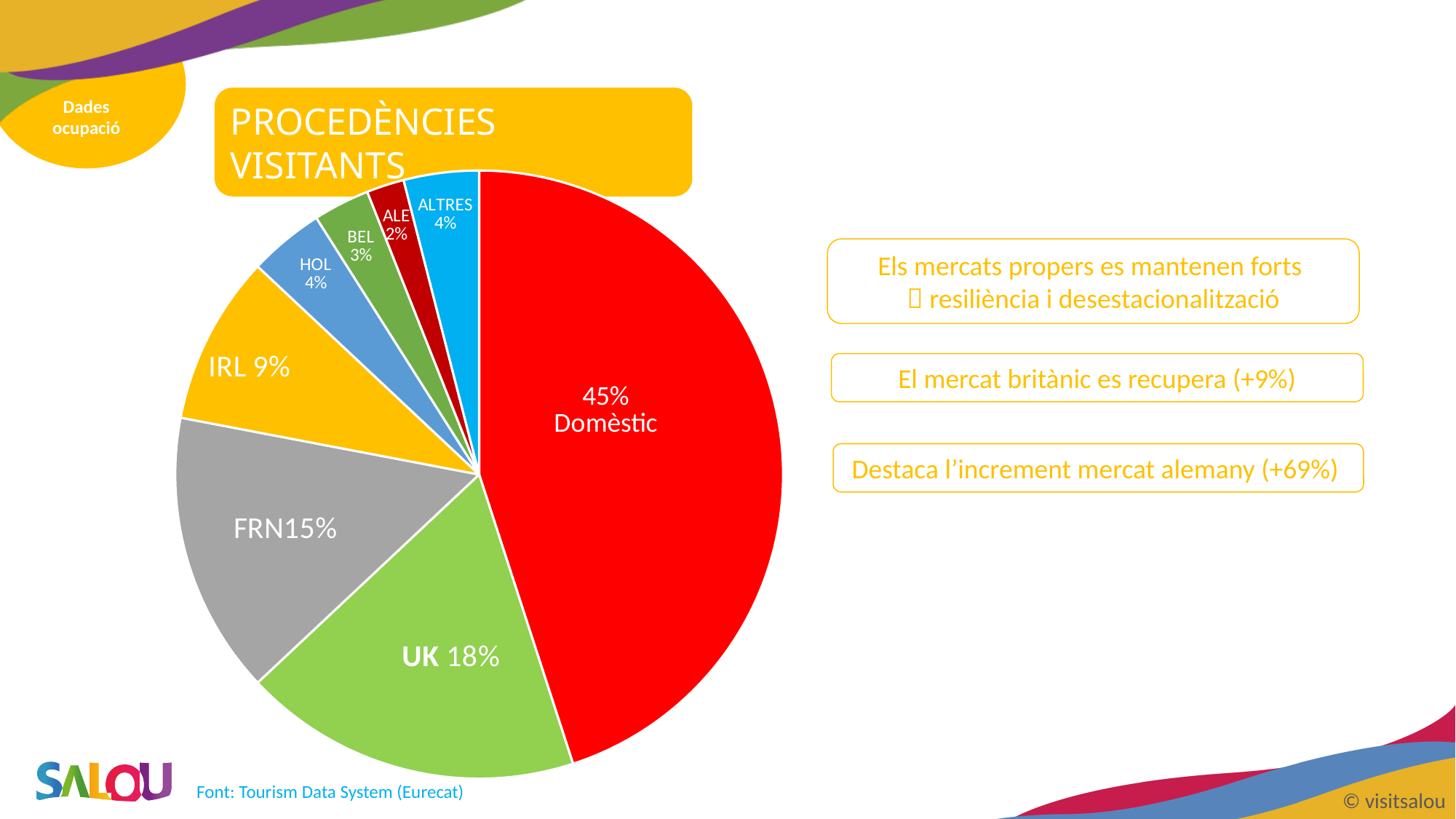
What percentage is shown for FRN? 15% Which is larger, the IRL slice or the HOL slice? IRL What kind of chart is shown on the slide? Pie chart What is the title of the chart? PROCEDÈNCIES VISITANTS How many slices does the pie chart have? 8 What percentage is shown for IRL? 9% What is the difference in percentage points between the UK and FRN slices? 3 What percentage is shown for BEL? 3% Which slice of the pie chart is the largest? Domèstic What share of visitors is Domèstic? 45% What percentage of visitors come from the UK? 18% Which slice of the pie chart is the smallest? ALE